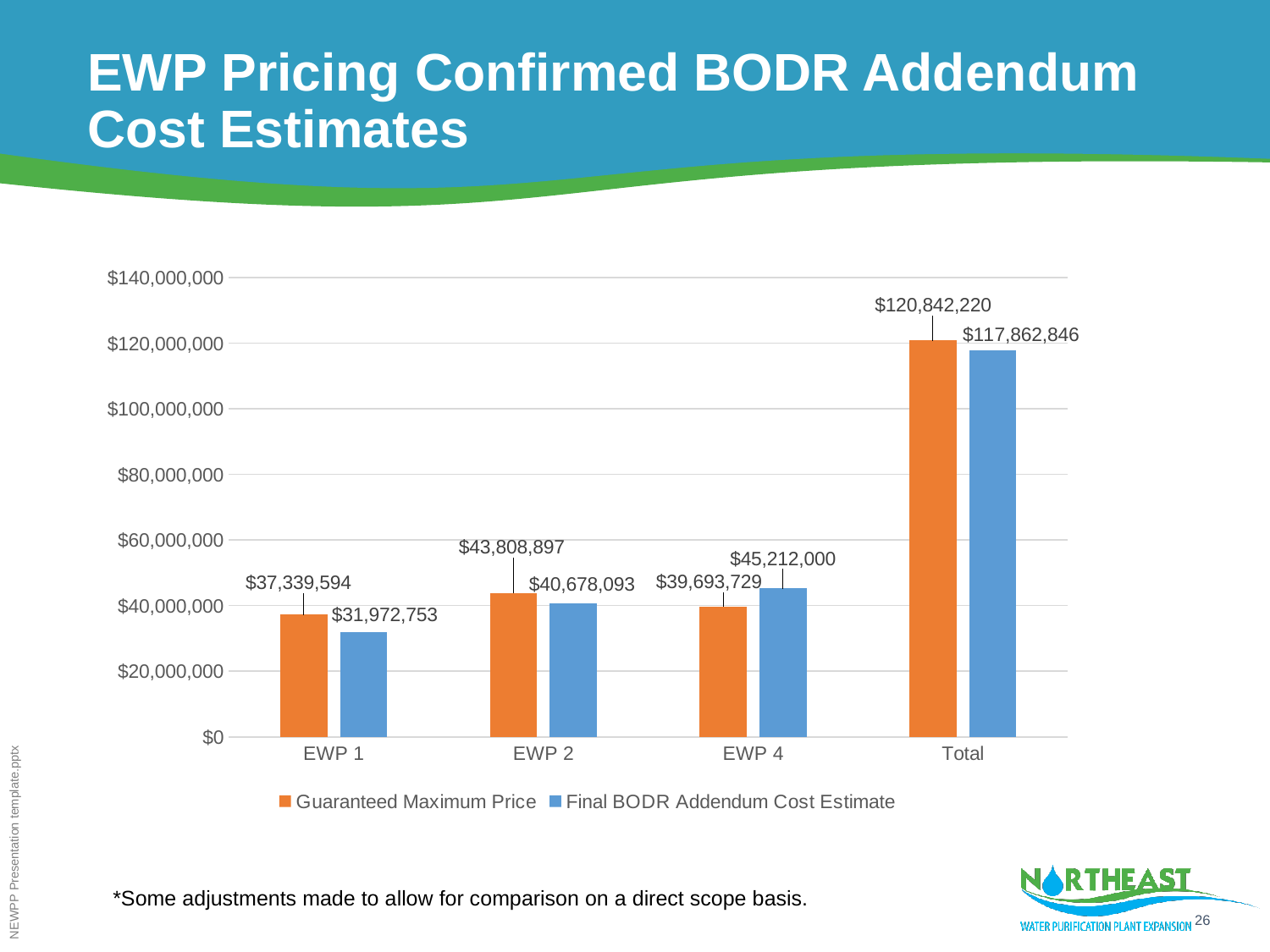
What is the difference between the Guaranteed Maximum Price and the Final BODR Addendum Cost Estimate for the Total category? $2,979,374 How many categories are shown on the x axis? 4 How many series does the legend list? 2 Excluding the Total category, which category has the highest Guaranteed Maximum Price? EWP 2 What is the difference between the Guaranteed Maximum Price and the Final BODR Addendum Cost Estimate for EWP 1? $5,366,841 What is the Final BODR Addendum Cost Estimate for EWP 4? $45,212,000 Is the Guaranteed Maximum Price for the Total category greater or less than $120,000,000? greater Which category has the lowest Final BODR Addendum Cost Estimate? EWP 1 What is the Guaranteed Maximum Price for EWP 2? $43,808,897 What is the Guaranteed Maximum Price for EWP 1? $37,339,594 What is the Final BODR Addendum Cost Estimate for the Total category? $117,862,846 For EWP 4, which is larger: the Guaranteed Maximum Price or the Final BODR Addendum Cost Estimate? Final BODR Addendum Cost Estimate